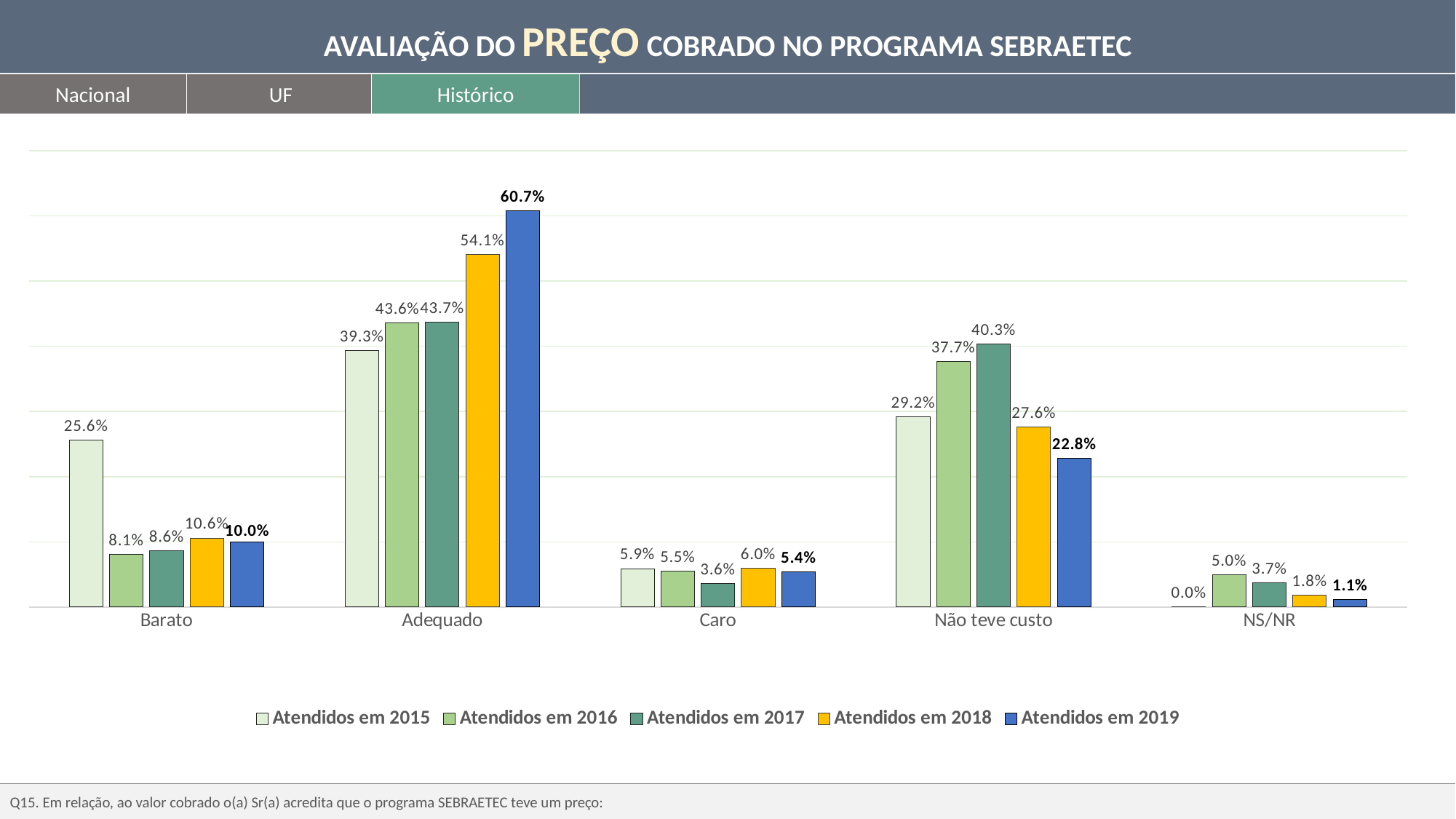
Which category has the highest value for Atendidos em 2018? Adequado What is the value for Adequado for Atendidos em 2019? 60.7% How many categories are shown on the x axis? 5 Which is larger for Caro: the value for Atendidos em 2018 or Atendidos em 2017? Atendidos em 2018 Which tab is highlighted in green below the title? Histórico What kind of chart is shown on the slide? Bar chart What is the value for Barato for Atendidos em 2015? 25.6% Which category has the lowest value for Atendidos em 2019? NS/NR What is the difference between the Atendidos em 2019 and Atendidos em 2018 values for Adequado? 6.6% What is the value for Não teve custo for Atendidos em 2017? 40.3% How many series does the legend list? 5 What is the value for NS/NR for Atendidos em 2015? 0.0%